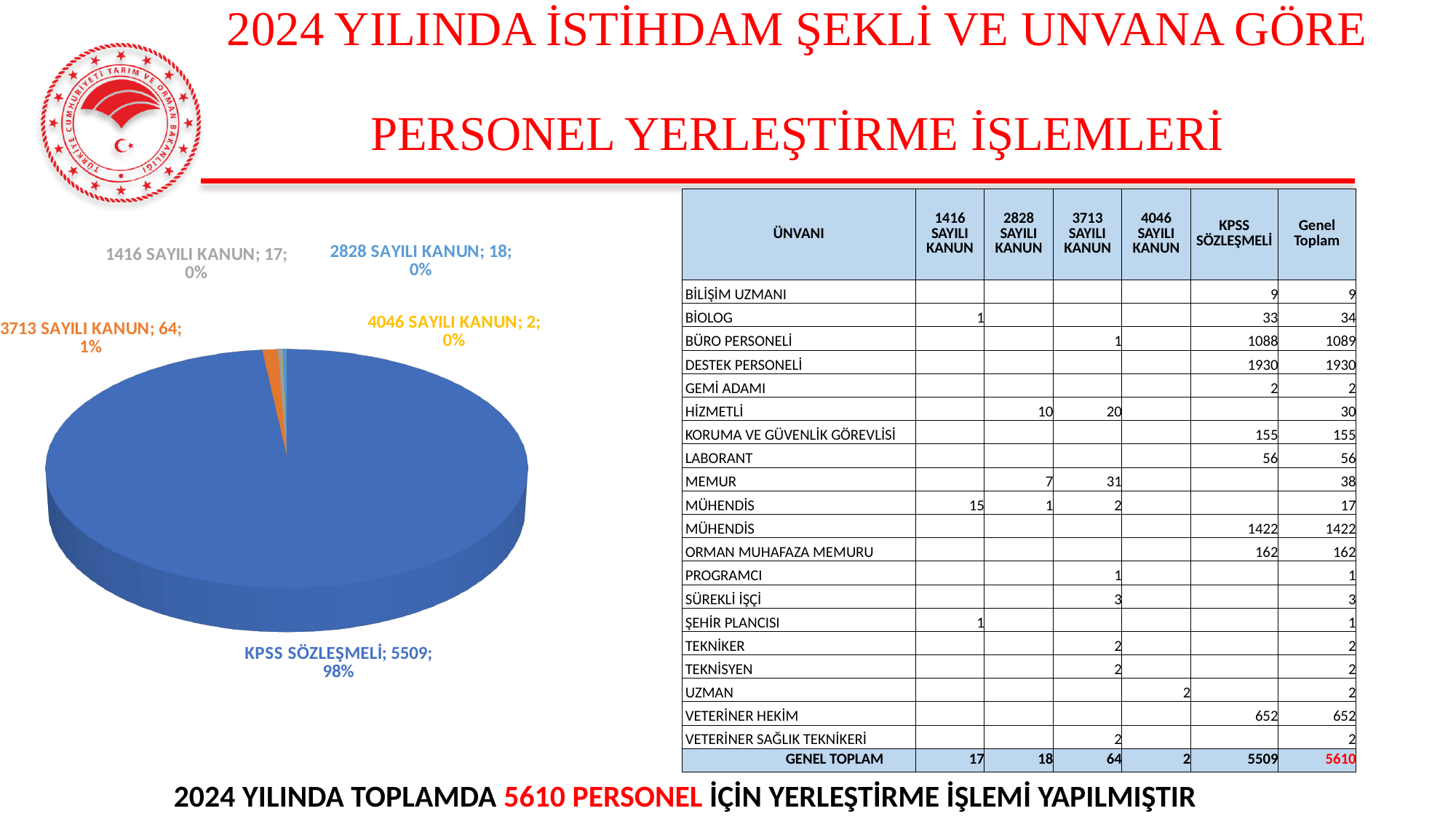
What percentage share of the pie chart does 3713 SAYILI KANUN have? 1% What is the value shown for 1416 SAYILI KANUN in the pie chart? 17 What is the value shown for 2828 SAYILI KANUN in the pie chart? 18 In the pie chart, what is the difference between the values for 3713 SAYILI KANUN and 2828 SAYILI KANUN? 46 What is the value shown for 3713 SAYILI KANUN in the pie chart? 64 What is the value shown for KPSS SÖZLEŞMELİ in the pie chart? 5509 Which category has the smallest slice in the pie chart? 4046 SAYILI KANUN How many slices does the pie chart have? 5 What kind of chart is shown on the left of the slide? Pie chart What is the value shown for 4046 SAYILI KANUN in the pie chart? 2 What percentage share of the pie chart does KPSS SÖZLEŞMELİ have? 98% Which category has the largest slice in the pie chart? KPSS SÖZLEŞMELİ